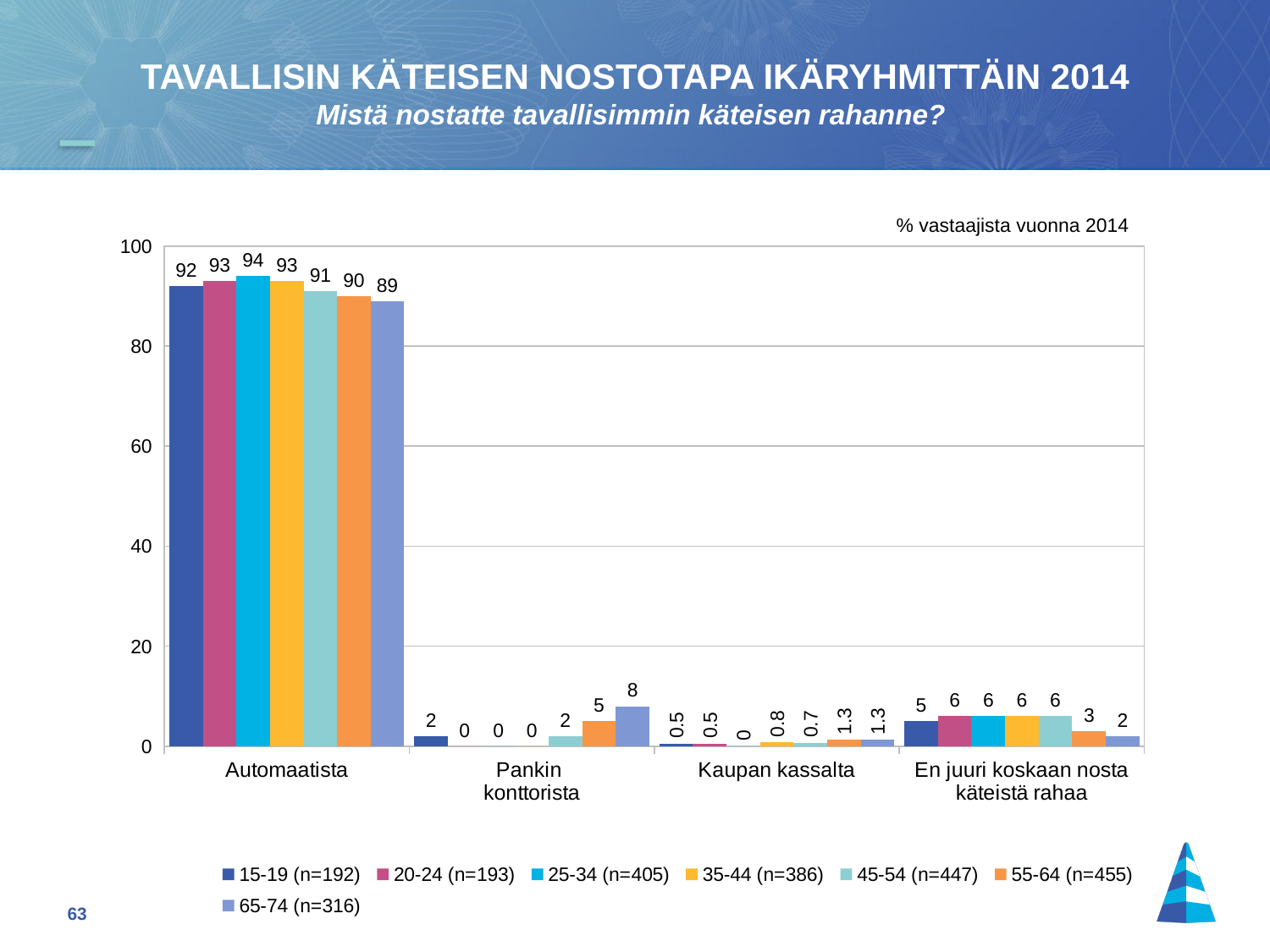
In the En juuri koskaan nosta käteistä rahaa category, which is larger: the value for 15-19 or the value for 55-64? 15-19 Which age group has the highest value in the Automaatista category? 25-34 (n=405) Is the value for the 55-64 age group in the Automaatista category greater or less than 80? greater What is the value for the 65-74 age group in the Pankin konttorista category? 8 What kind of chart is shown on the slide? Bar chart Which age group has the lowest value in the Automaatista category? 65-74 (n=316) What is the value for the 25-34 age group in the Automaatista category? 94 What is the value for the 55-64 age group in the Kaupan kassalta category? 1.3 How many series does the legend list? 7 What is the difference between the 15-19 and 65-74 values in the Automaatista category? 3 How many categories are shown on the x axis? 4 What unit is indicated in the note above the chart? % vastaajista vuonna 2014